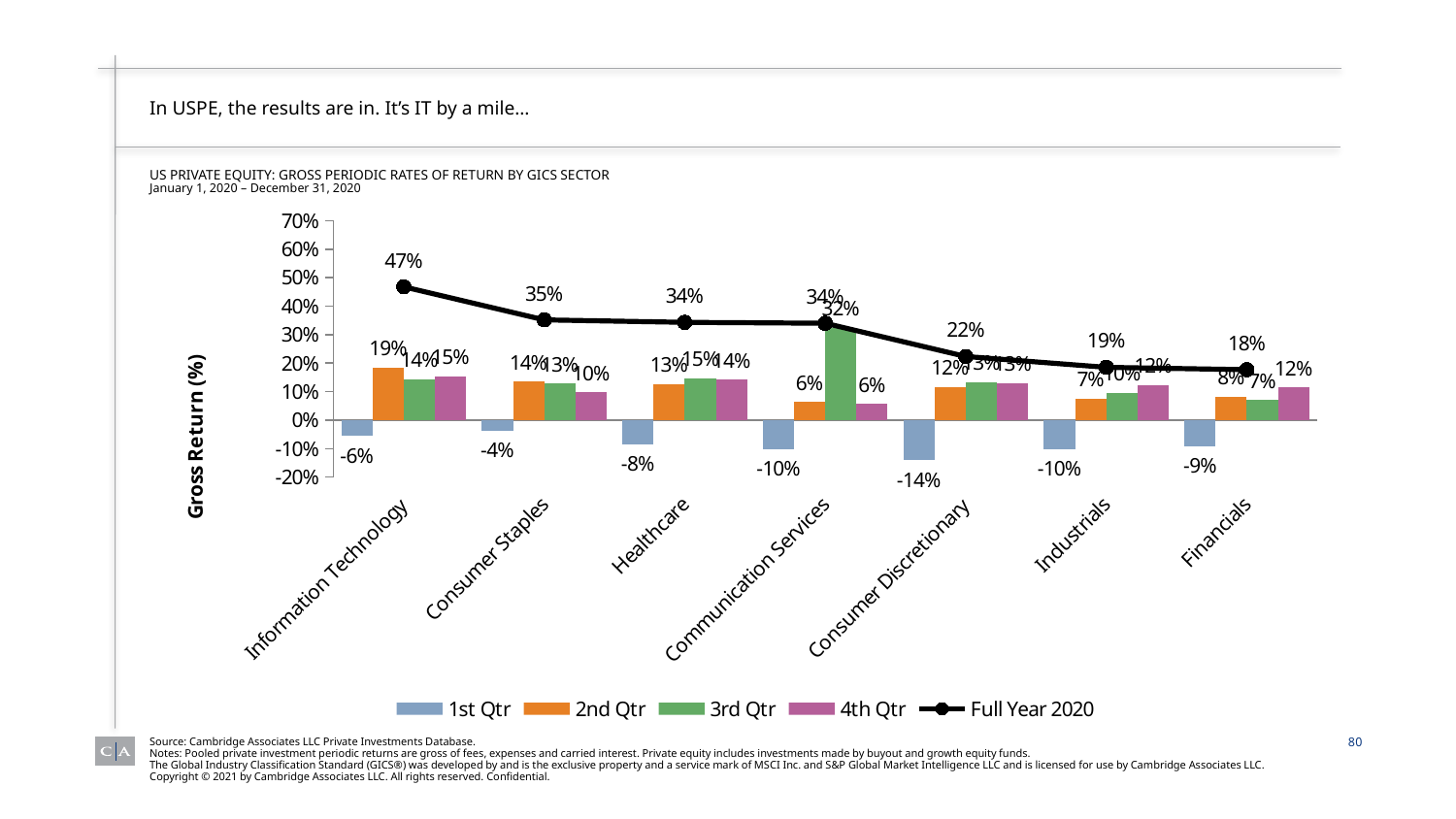
Which sector has the highest Full Year 2020 gross return? Information Technology What is the Full Year 2020 gross return for Information Technology? 47% Which sector has the lowest Full Year 2020 gross return? Financials Which sector has the lowest 1st Qtr gross return? Consumer Discretionary How many sectors are shown on the x axis? 7 What is the 3rd Qtr gross return for Communication Services? 32% What is the 1st Qtr gross return for Consumer Discretionary? -14% What kind of chart is this? Combined bar and line chart What is the difference between the Full Year 2020 returns for Information Technology and Financials? 29 percentage points Which is larger, the Full Year 2020 return for Consumer Staples or for Industrials? Consumer Staples Does the Full Year 2020 line rise or fall from left to right across the sectors? Fall How many series does the legend list? 5